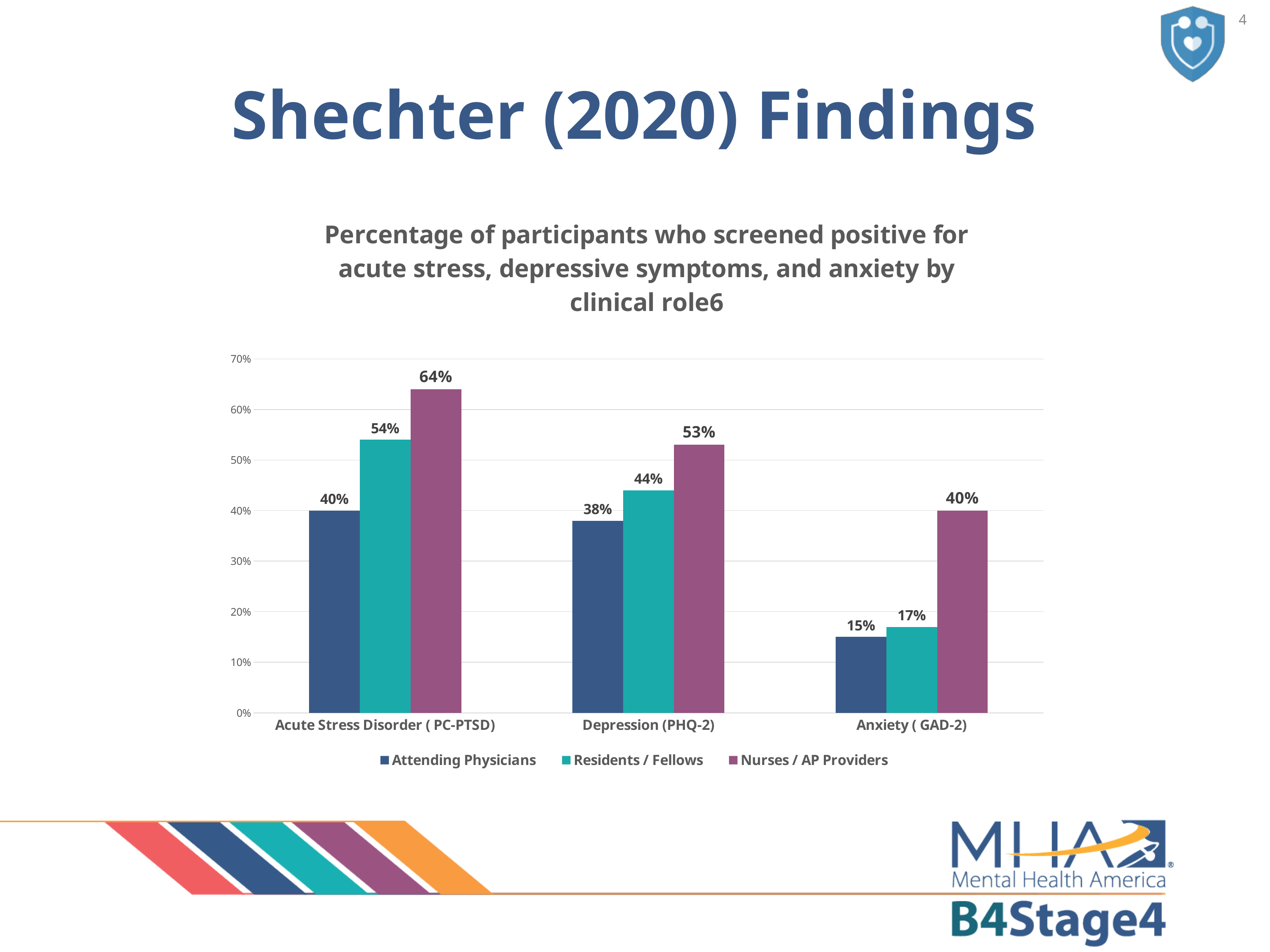
How many screening categories are shown on the x axis? 3 What percentage of Attending Physicians screened positive for Depression (PHQ-2)? 38% What percentage of Residents / Fellows screened positive for Anxiety (GAD-2)? 17% Which series is shown in purple in the legend? Nurses / AP Providers Is the Nurses / AP Providers value for Anxiety (GAD-2) greater or less than 30%? greater What percentage of Nurses / AP Providers screened positive for Acute Stress Disorder (PC-PTSD)? 64% How many series does the legend list? 3 Which clinical role has the lowest percentage screening positive for Anxiety (GAD-2)? Attending Physicians What kind of chart is shown on the slide? Bar chart What is the difference between the Nurses / AP Providers and Attending Physicians percentages for Acute Stress Disorder (PC-PTSD)? 24% Which clinical role has the highest percentage screening positive for Depression (PHQ-2)? Nurses / AP Providers Which is larger: the Residents / Fellows value for Acute Stress Disorder (PC-PTSD) or the Residents / Fellows value for Depression (PHQ-2)? Acute Stress Disorder (PC-PTSD)